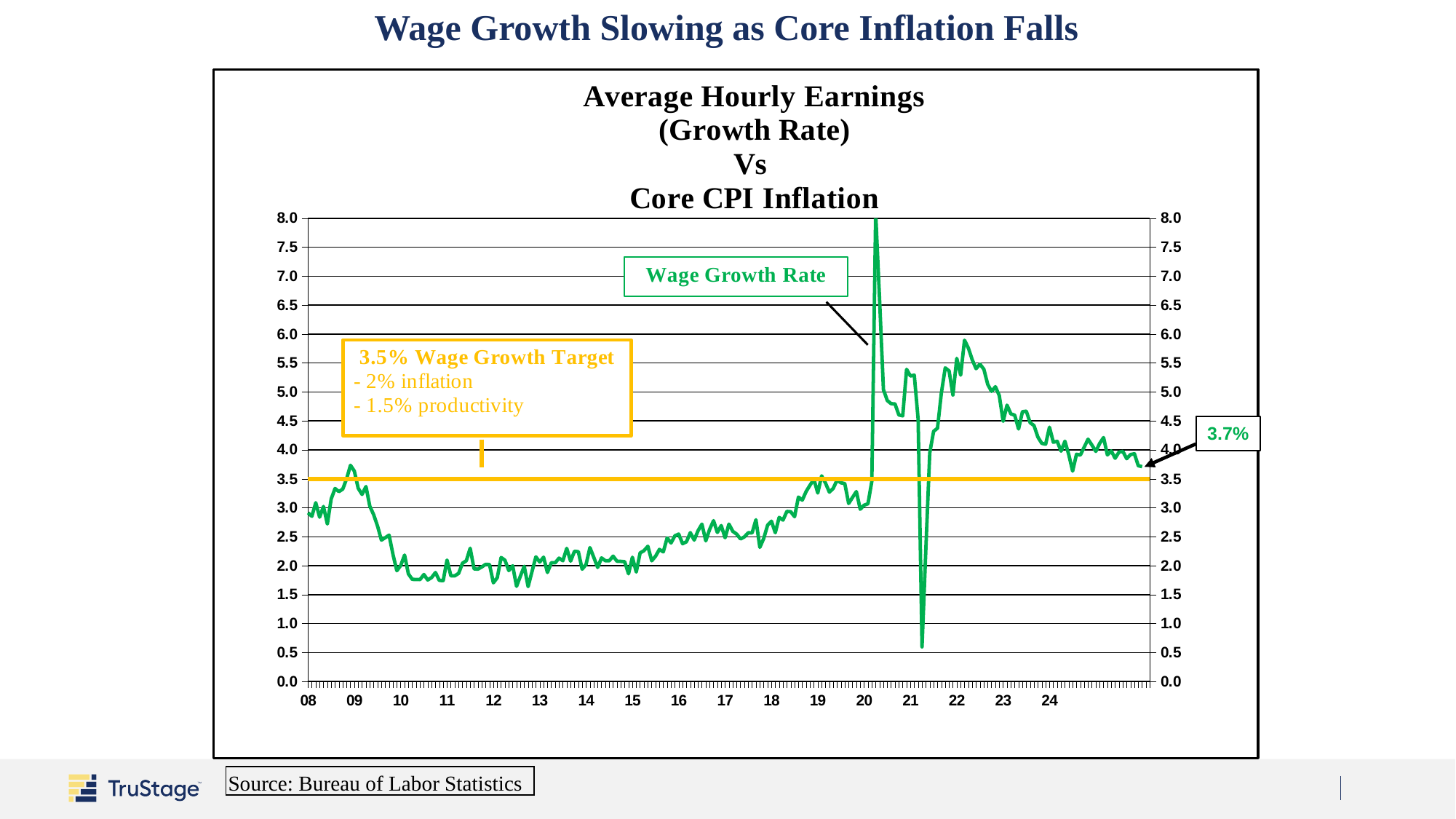
What kind of chart is shown on the slide? line chart Is the Wage Growth Rate in 2012 greater or less than 3.0? less What two components make up the 3.5% Wage Growth Target according to the annotation? 2% inflation and 1.5% productivity From 2022 to 2024, does the Wage Growth Rate rise or fall? fall Is the latest Wage Growth Rate of 3.7% above or below the 3.5% Wage Growth Target? above What is the most recent value of the Wage Growth Rate labeled on the chart? 3.7% Is the Wage Growth Rate in 2011 greater or less than 2.5? less By how many percentage points does the latest Wage Growth Rate of 3.7% exceed the 3.5% target? 0.2 What value does the horizontal yellow Wage Growth Target line mark? 3.5% Is the Wage Growth Rate in 2022 greater or less than 4.5? greater What is the title of the chart? Average Hourly Earnings (Growth Rate) Vs Core CPI Inflation